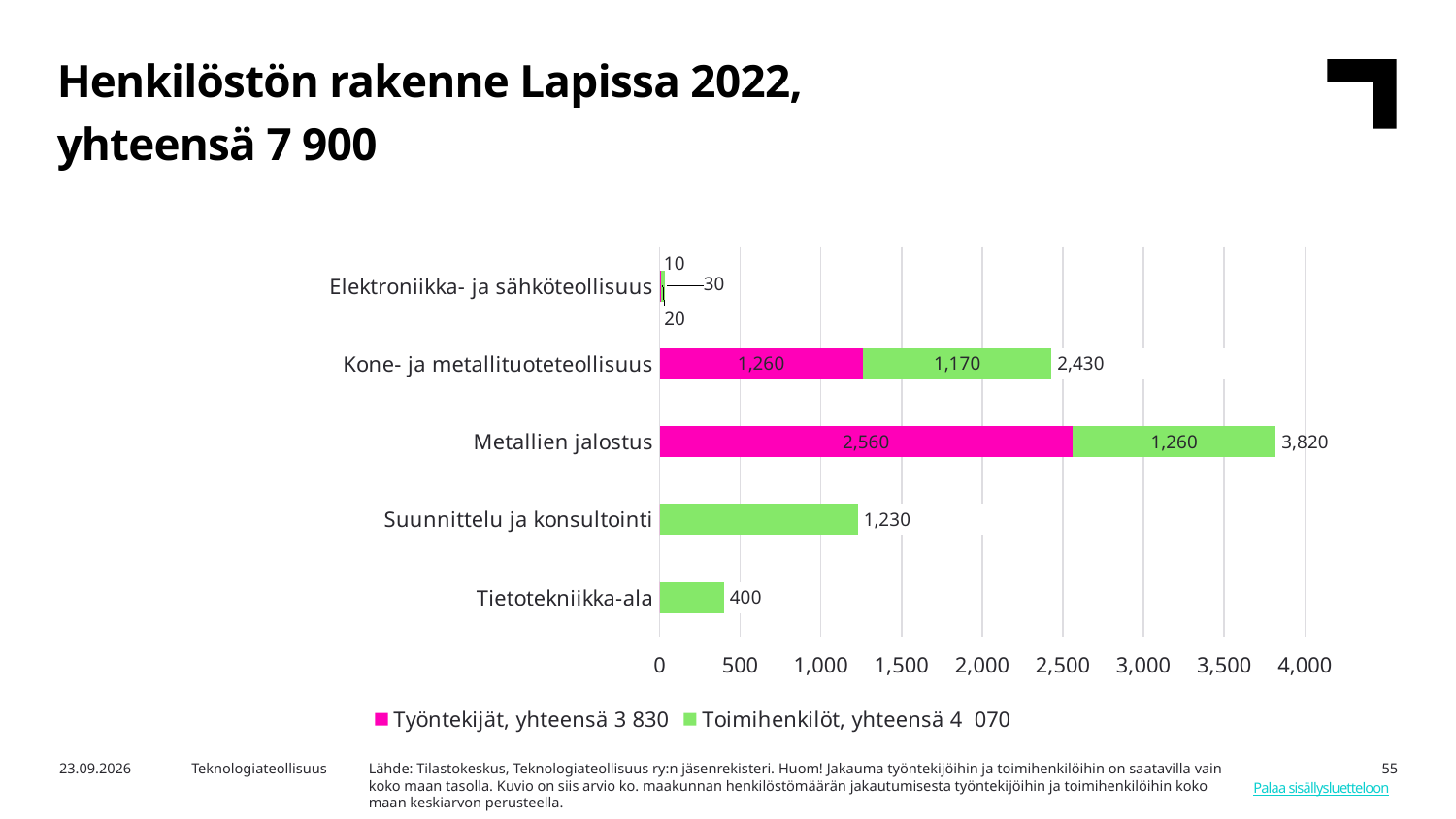
Which category has the highest total? Metallien jalostus What total is given for Toimihenkilöt in the legend? 4 070 What is the total value shown for Kone- ja metallituoteteollisuus? 2,430 What is the Työntekijät value for Metallien jalostus? 2,560 What is the difference between the Työntekijät values for Metallien jalostus and Kone- ja metallituoteteollisuus? 1,300 Which is larger, the value for Suunnittelu ja konsultointi or the value for Tietotekniikka-ala? Suunnittelu ja konsultointi What is the Toimihenkilöt value for Kone- ja metallituoteteollisuus? 1,170 How many series does the legend list? 2 What kind of chart is shown on the slide? Stacked bar chart What is the total value shown for Metallien jalostus? 3,820 How many categories are shown on the chart? 5 Which category has the lowest total? Elektroniikka- ja sähköteollisuus